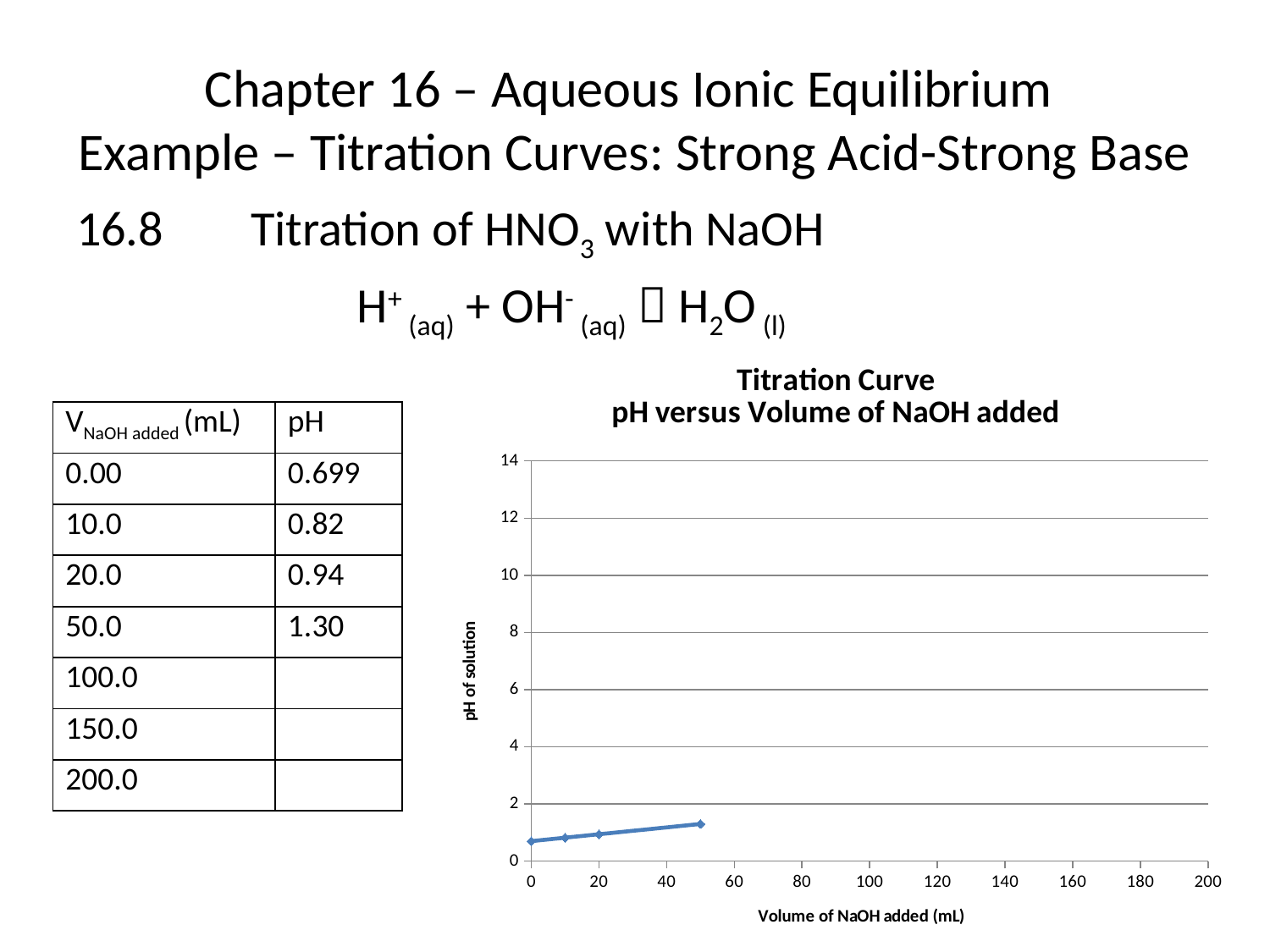
Is the pH value plotted at 0 mL of NaOH added greater or less than 2? less What is the difference in pH between 20.0 mL and 10.0 mL of NaOH added? 0.12 What is the pH when 0.00 mL of NaOH has been added? 0.699 What is the title of the chart? Titration Curve pH versus Volume of NaOH added Is the pH value plotted at 50 mL of NaOH added greater or less than 2? less Do the plotted pH values rise or fall as the volume of NaOH added increases? rise How many data points are plotted on the chart? 4 What is the label of the x axis of the chart? Volume of NaOH added (mL) What is the pH when 50.0 mL of NaOH has been added? 1.30 What kind of chart is shown on the slide? line chart At which volume of NaOH added is the plotted pH lowest? 0.00 mL At which volume of NaOH added is the plotted pH highest? 50.0 mL